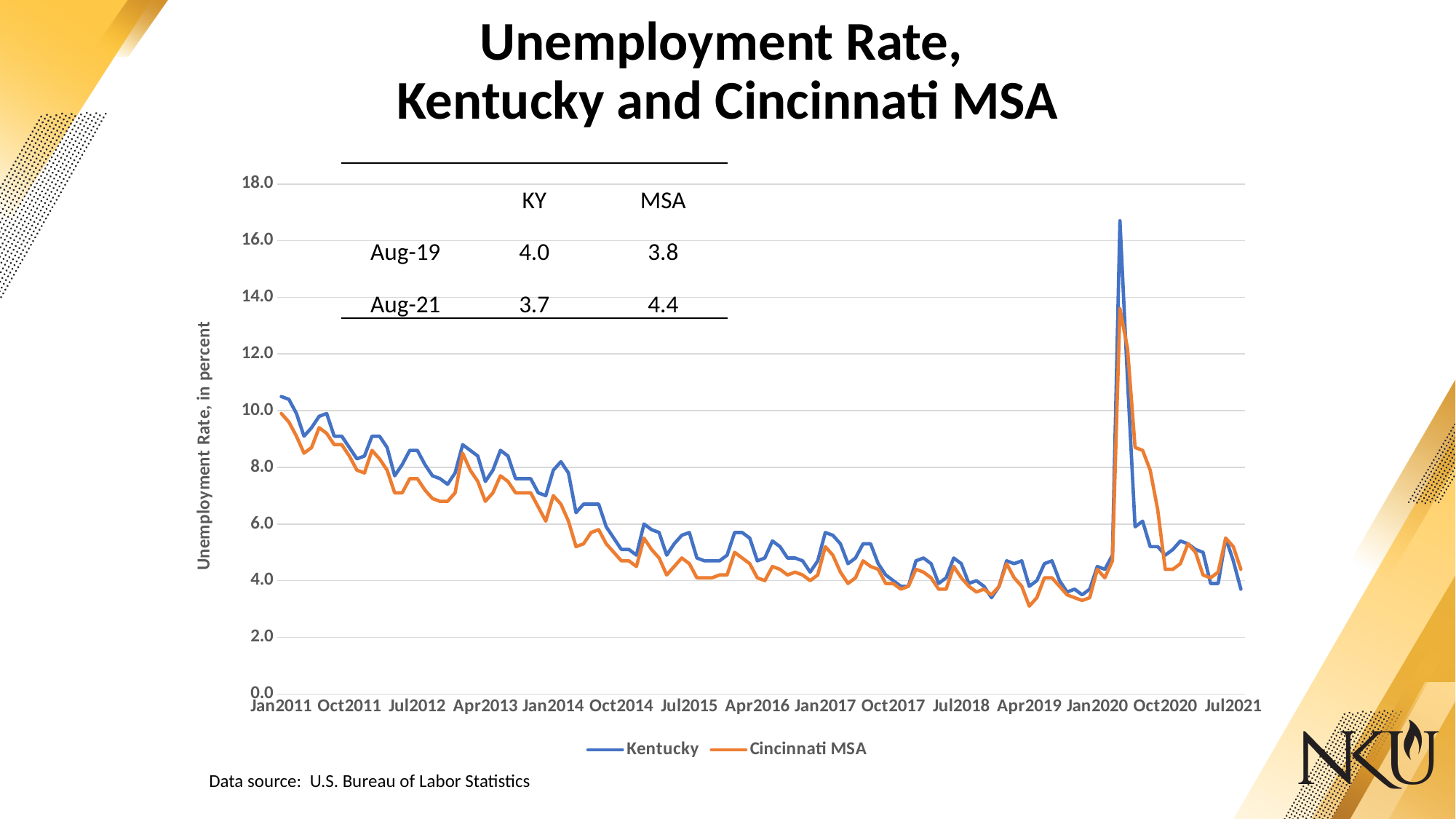
According to the inset table, what was the MSA unemployment rate in Aug-21? 4.4 How many series does the legend list? 2 Is the peak value of the Kentucky line in 2020 greater or less than 16.0? greater What is the label on the vertical axis? Unemployment Rate, in percent Which series reached the higher peak in 2020, Kentucky or Cincinnati MSA? Kentucky What are the two series named in the legend? Kentucky and Cincinnati MSA What kind of chart is shown on the slide? line chart According to the inset table, what was the KY unemployment rate in Aug-21? 3.7 In Aug-21, how much higher was the MSA rate than the KY rate, per the inset table? 0.7 In Aug-19, which had the higher unemployment rate, KY or MSA? KY According to the inset table, what was the MSA unemployment rate in Aug-19? 3.8 According to the inset table, what was the KY unemployment rate in Aug-19? 4.0